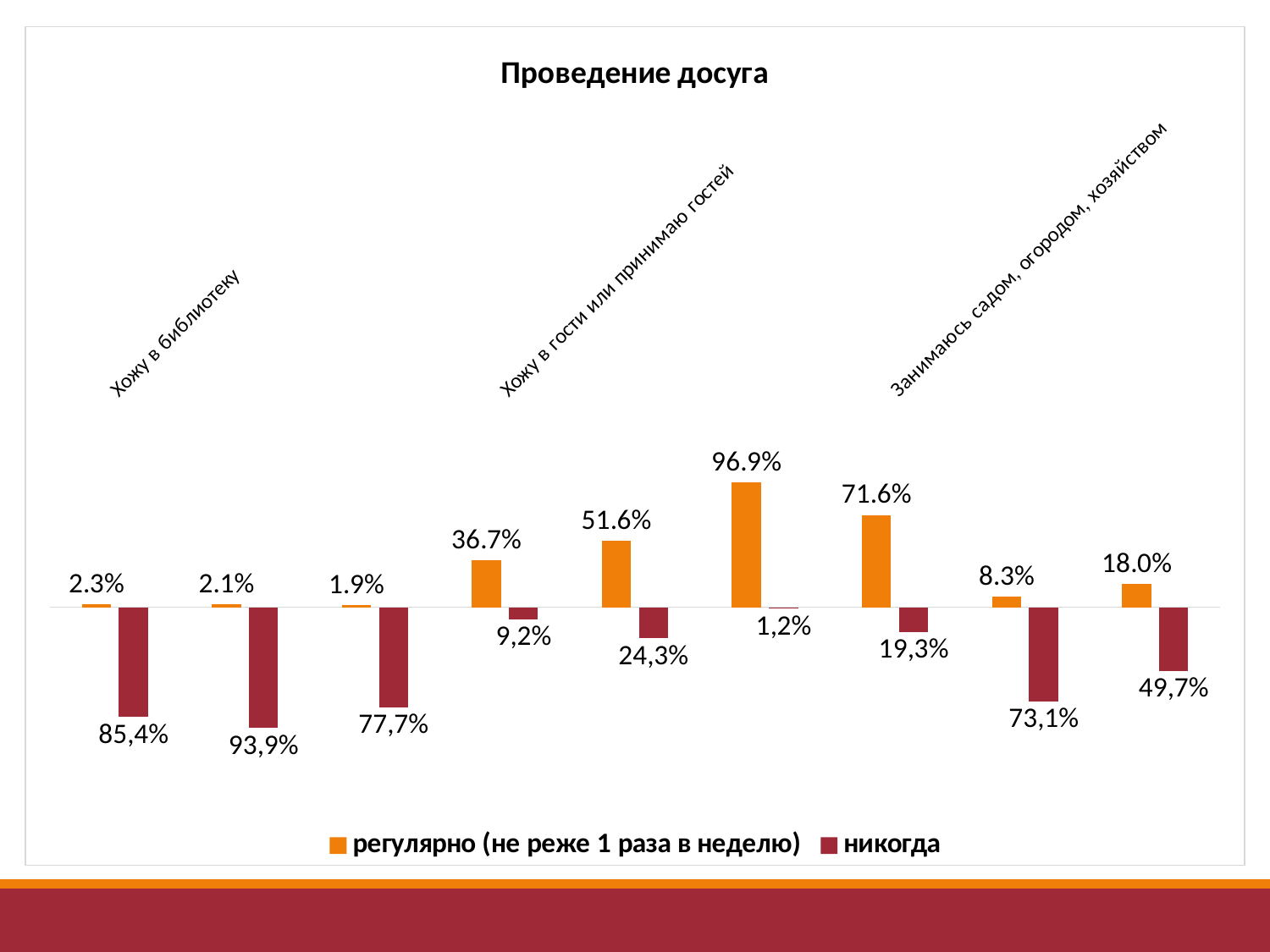
How many series does the legend list? 2 What is the highest value shown for the 'регулярно (не реже 1 раза в неделю)' series? 96.9% What is the title of the chart? Проведение досуга What kind of chart is shown on the slide? bar chart Which is larger: the highest 'регулярно' value or the highest 'никогда' value? the highest 'регулярно' value (96.9%) What is the highest value shown for the 'никогда' series? 93,9% What is the difference between the highest 'регулярно' value (96.9%) and the highest 'никогда' value (93,9%)? 3.0 percentage points What is the lowest value shown for the 'никогда' series? 1,2% How many category labels are written along the chart? 3 How many pairs of bars are plotted in the chart? 9 What are the two series named in the legend? регулярно (не реже 1 раза в неделю) and никогда What is the lowest value shown for the 'регулярно (не реже 1 раза в неделю)' series? 1.9%